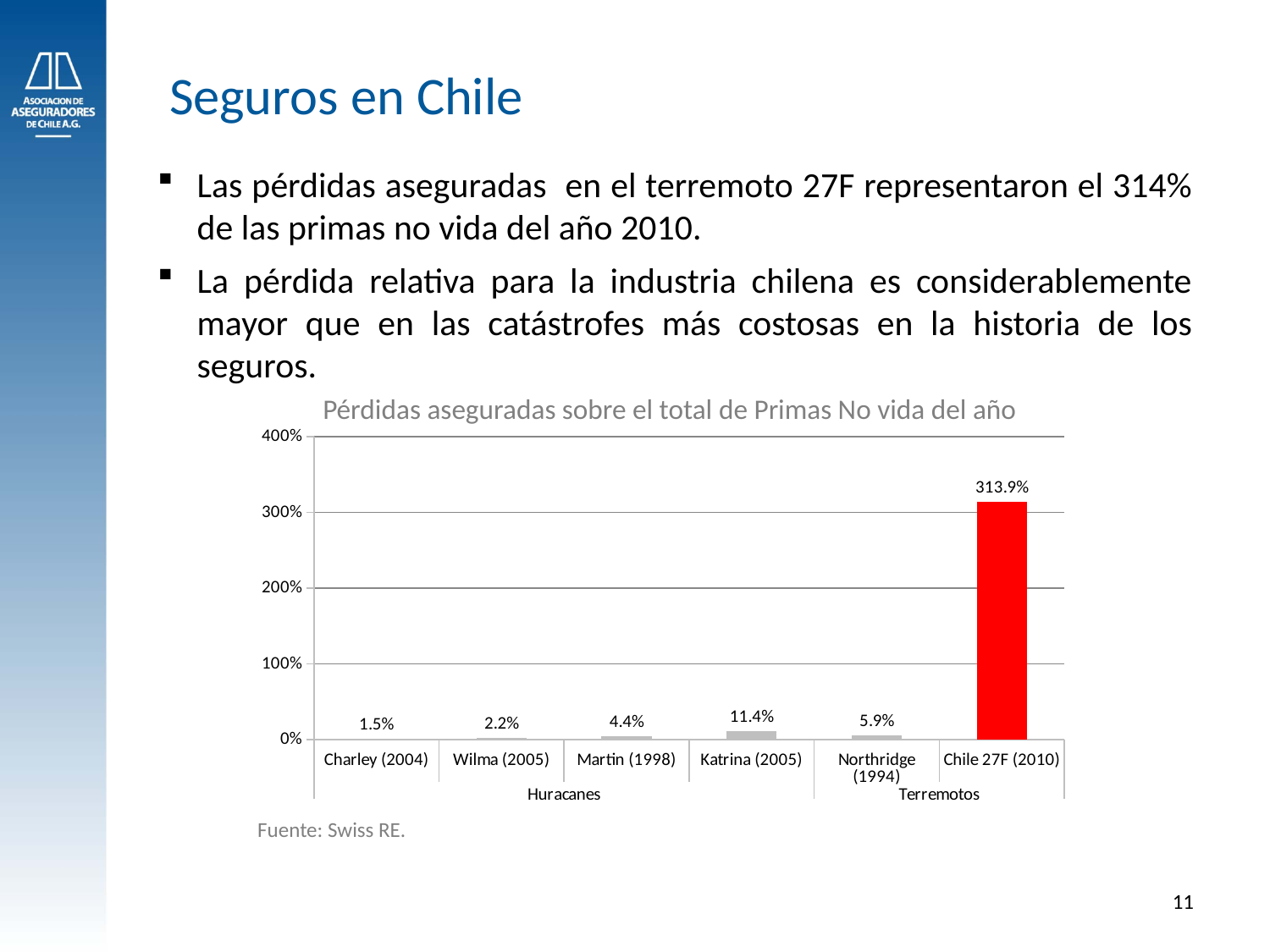
What is the title of the chart? Pérdidas aseguradas sobre el total de Primas No vida del año What kind of chart is shown on the slide? Bar chart Which is larger, the value for Wilma (2005) or the value for Martin (1998)? Martin (1998) What is the value for Chile 27F (2010)? 313.9% What is the difference between the values for Katrina (2005) and Northridge (1994)? 5.5% Which category has the lowest value? Charley (2004) What is the value for Katrina (2005)? 11.4% How many categories are shown in the chart? 6 What is the value for Northridge (1994)? 5.9% What is the value for Charley (2004)? 1.5% Which category has the highest value? Chile 27F (2010) Is the value for Chile 27F (2010) greater or less than 300%? greater